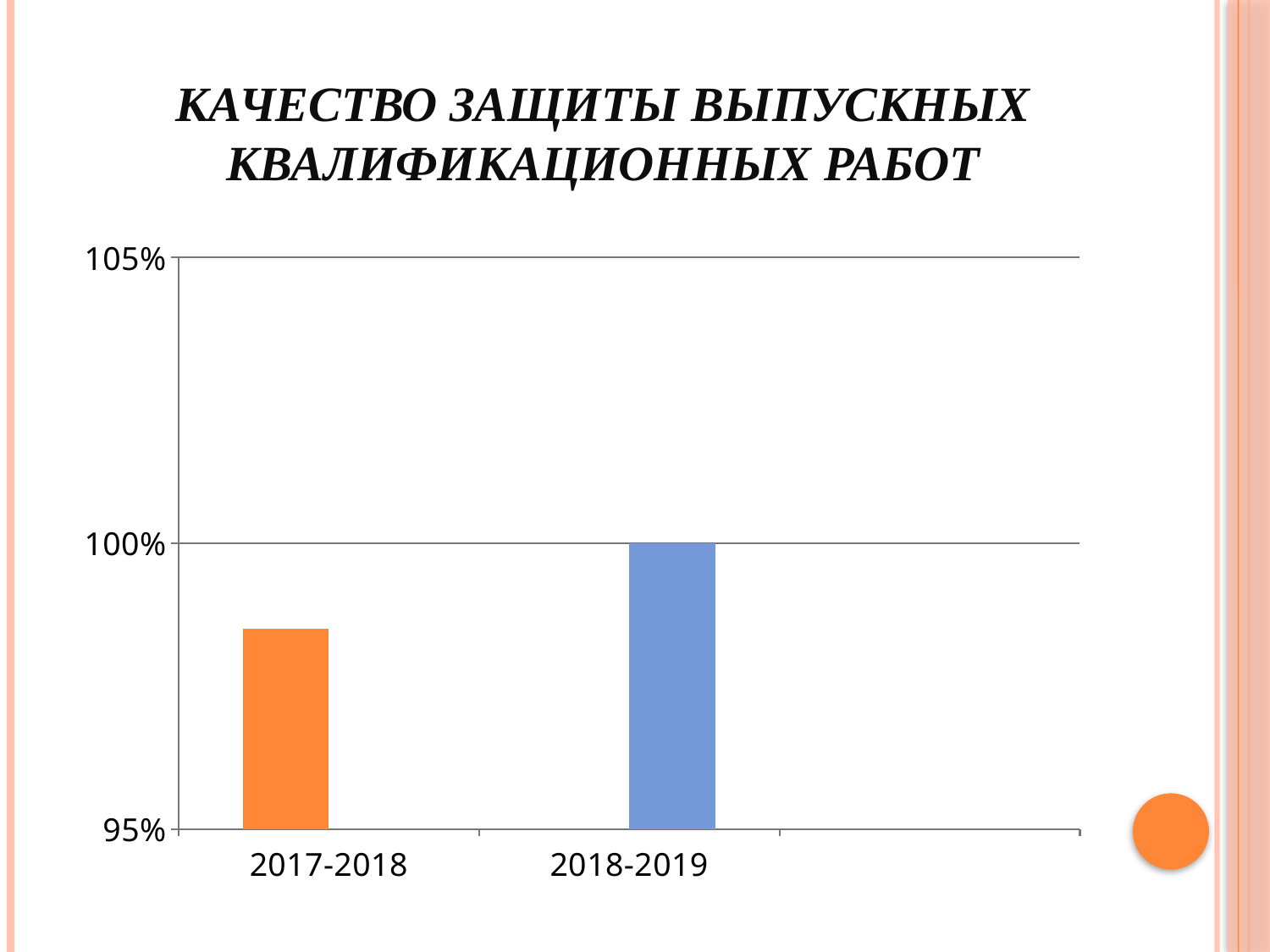
What is the title of the slide? КАЧЕСТВО ЗАЩИТЫ ВЫПУСКНЫХ КВАЛИФИКАЦИОННЫХ РАБОТ Which category has the highest value? 2018-2019 What is the value for 2018-2019? 100% What colour is the bar for 2017-2018? orange Is the value for 2017-2018 greater or less than 95%? greater Which is larger, the value for 2017-2018 or the value for 2018-2019? 2018-2019 How many categories are plotted on the x axis? 2 Which category has the lowest value? 2017-2018 Is the value for 2017-2018 greater or less than 100%? less Do the values rise or fall from 2017-2018 to 2018-2019? rise What kind of chart is shown on the slide? bar chart